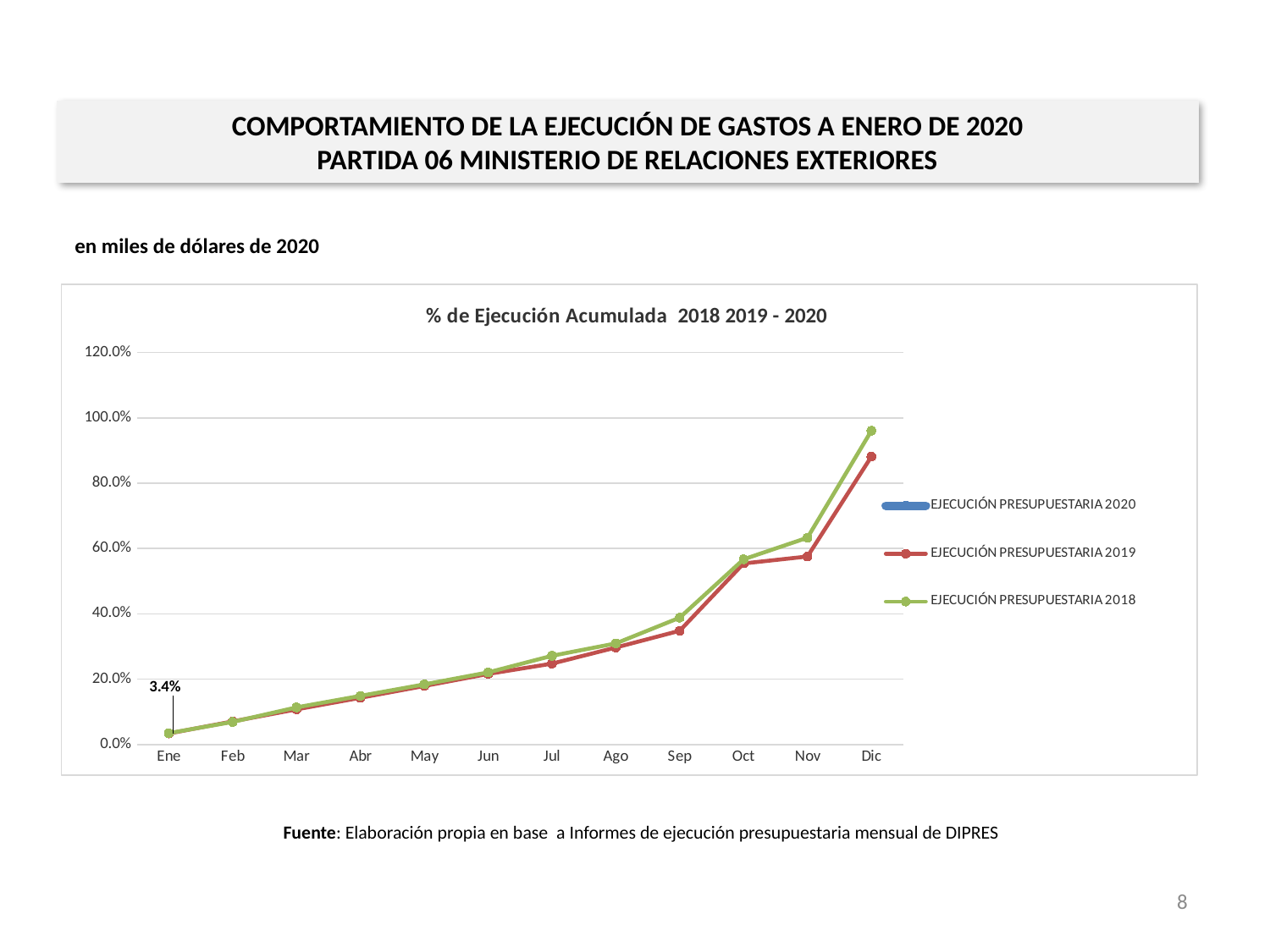
What is the value labelled for EJECUCIÓN PRESUPUESTARIA 2020 in Ene? 3.4% How many series does the legend list? 3 Is the value for EJECUCIÓN PRESUPUESTARIA 2019 in Mar greater or less than 20.0%? less What is the title of the chart? % de Ejecución Acumulada 2018 2019 - 2020 In which month does EJECUCIÓN PRESUPUESTARIA 2019 reach its highest value? Dic In Dic, which series is higher, EJECUCIÓN PRESUPUESTARIA 2018 or EJECUCIÓN PRESUPUESTARIA 2019? EJECUCIÓN PRESUPUESTARIA 2018 How many months are shown along the x axis? 12 Do the values for EJECUCIÓN PRESUPUESTARIA 2018 rise or fall from Ene to Dic? rise Is the value for EJECUCIÓN PRESUPUESTARIA 2018 in Dic greater or less than 80.0%? greater Is the value for EJECUCIÓN PRESUPUESTARIA 2018 in Jul greater or less than 20.0%? greater What kind of chart is shown on the slide? line chart